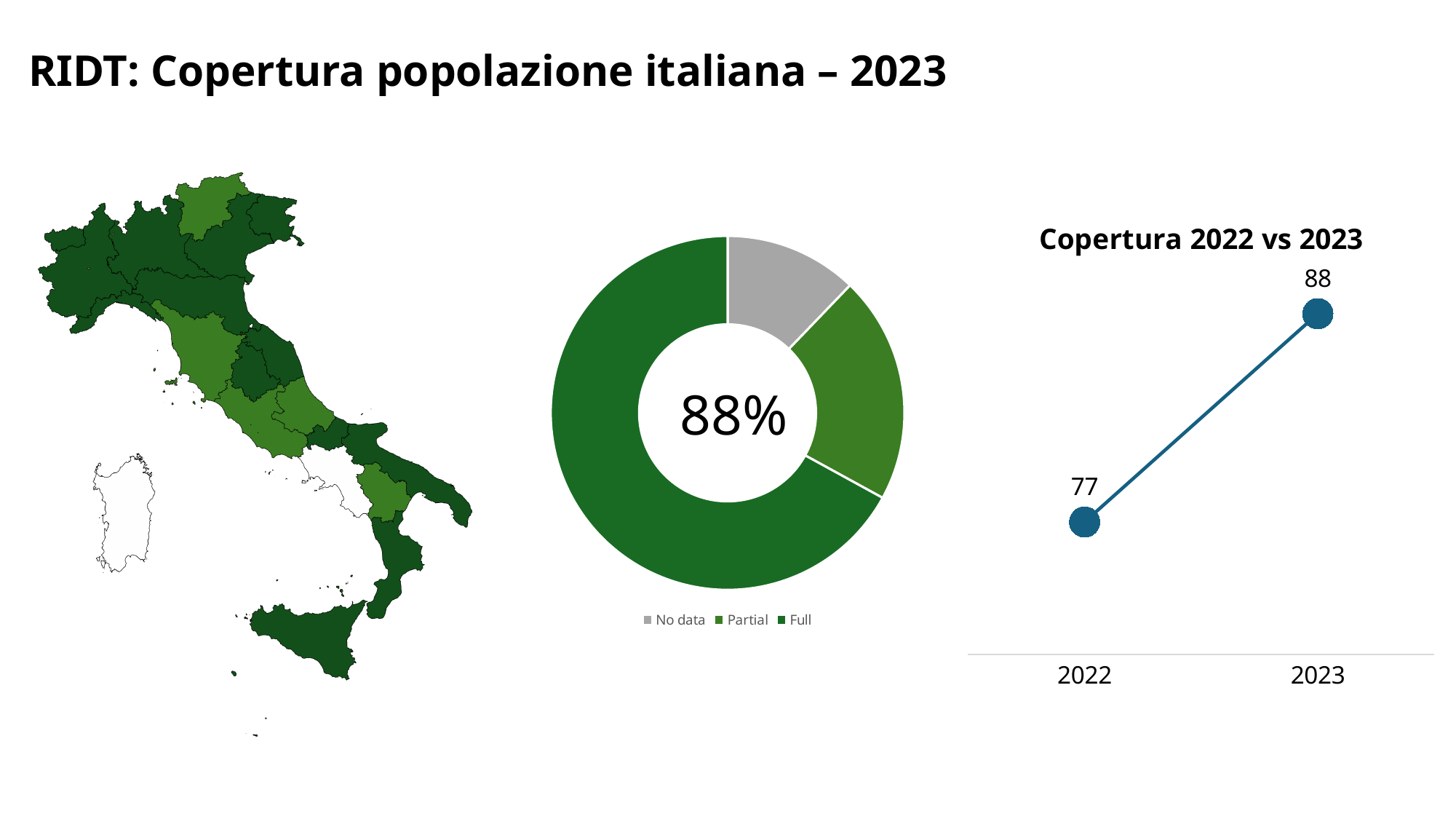
How many data points are plotted in the line chart titled "Copertura 2022 vs 2023"? 2 How many categories does the legend of the donut chart in the middle of the slide list? 3 In the line chart titled "Copertura 2022 vs 2023", which year has the higher value, 2022 or 2023? 2023 In the line chart titled "Copertura 2022 vs 2023", what is the difference between the 2023 and 2022 values? 11 In the donut chart in the middle of the slide, which category has the smallest slice? No data In the line chart titled "Copertura 2022 vs 2023", what is the value for 2022? 77 In the donut chart in the middle of the slide, which category has the largest slice? Full What percentage is shown in the centre of the donut chart in the middle of the slide? 88% In the line chart titled "Copertura 2022 vs 2023", do the values rise or fall from 2022 to 2023? rise In the line chart titled "Copertura 2022 vs 2023", what is the value for 2023? 88 What kind of chart is the one titled "Copertura 2022 vs 2023"? line chart What kind of chart is the one in the middle of the slide with the legend "No data", "Partial", "Full"? donut chart